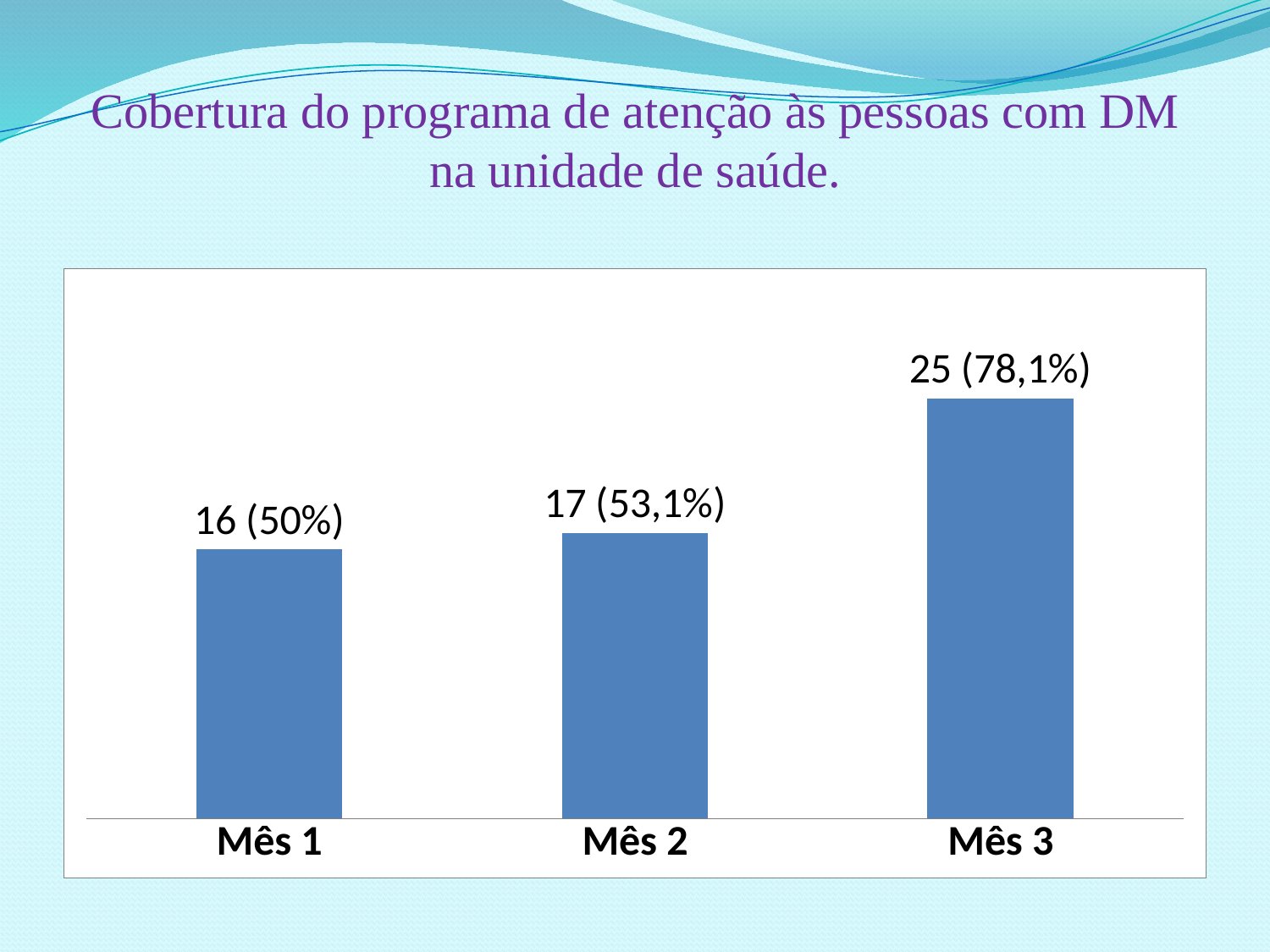
Which month has the highest value? Mês 3 Which month has the lowest value? Mês 1 What is the data label shown for Mês 3? 25 (78,1%) What is the data label shown for Mês 1? 16 (50%) Which is larger, the value for Mês 2 or the value for Mês 3? Mês 3 What is the difference between the count for Mês 3 and the count for Mês 1? 9 What is the difference between the count for Mês 2 and the count for Mês 1? 1 How many months are shown on the x axis? 3 What kind of chart is shown on the slide? Bar chart What percentage is shown for Mês 3? 78,1% What is the data label shown for Mês 2? 17 (53,1%) Do the values rise or fall from Mês 1 to Mês 3? Rise